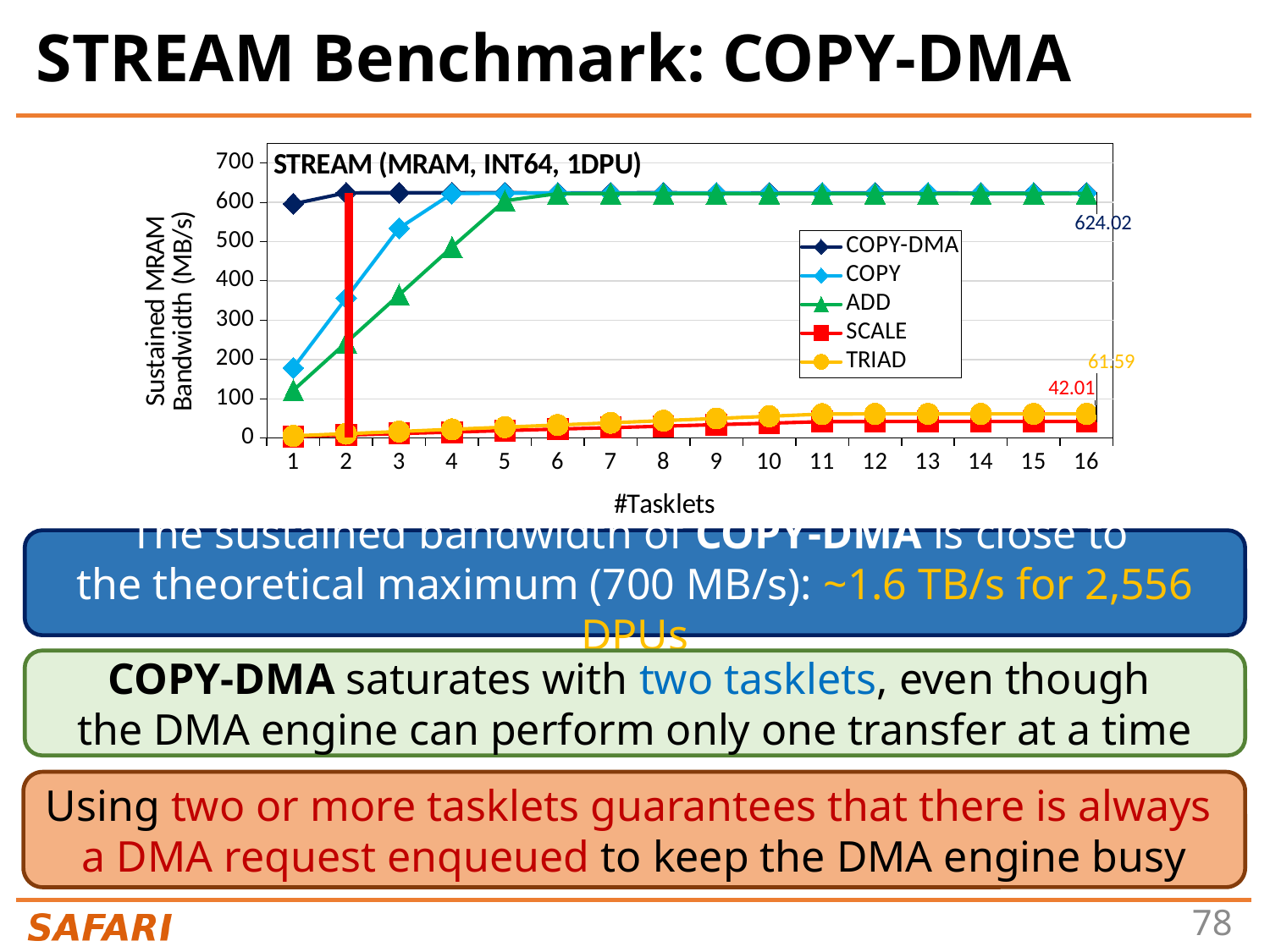
What is the difference between the labelled TRIAD and SCALE values at 16 tasklets? 19.58 What is the labelled sustained bandwidth of COPY-DMA at 16 tasklets? 624.02 Is the value for COPY at 3 tasklets greater or less than 400? greater Which series has the lowest sustained bandwidth at 16 tasklets? SCALE What is the labelled sustained bandwidth of TRIAD at 16 tasklets? 61.59 What is the title printed inside the chart area? STREAM (MRAM, INT64, 1DPU) What kind of chart is shown on the slide? line chart How many series does the chart legend list? 5 Does the ADD series rise or fall as the number of tasklets increases from 1 to 5? rise How many tasklet values are plotted along the x axis? 16 What is the labelled sustained bandwidth of SCALE at 16 tasklets? 42.01 Is the value for ADD at 1 tasklet greater or less than 200? less